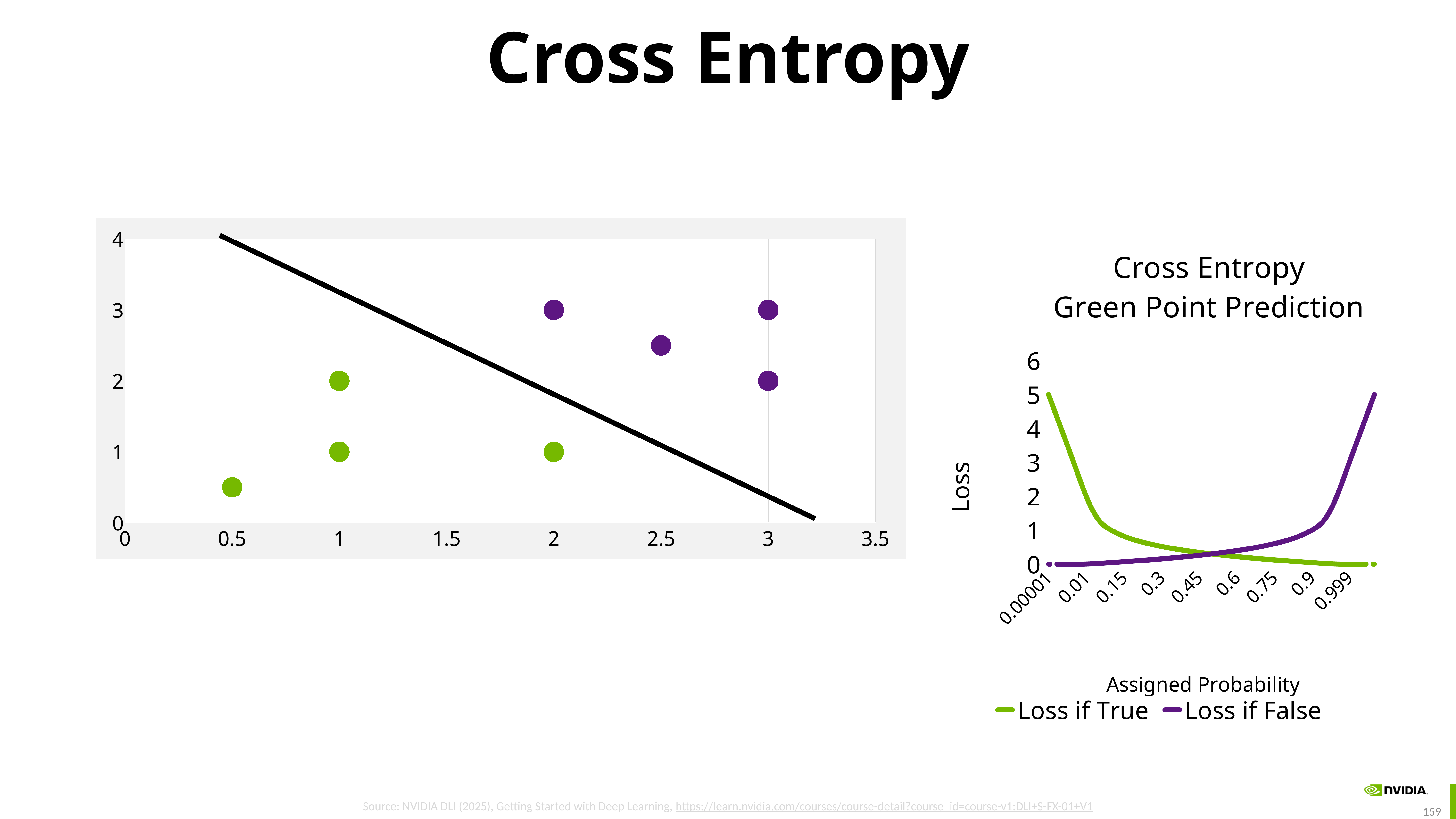
What kind of chart is the chart on the left of the slide? scatter chart What is the y-axis title of the 'Cross Entropy Green Point Prediction' chart? Loss In the 'Cross Entropy Green Point Prediction' chart, how many assigned probability labels are shown on the x axis? 9 In the 'Cross Entropy Green Point Prediction' chart, is the 'Loss if True' value at 0.00001 greater or less than 4? greater In the 'Cross Entropy Green Point Prediction' chart, does the 'Loss if False' line rise or fall as assigned probability increases? rise What kind of chart is the chart titled 'Cross Entropy Green Point Prediction'? line chart In the chart on the left, how many points are plotted in total? 8 In the 'Cross Entropy Green Point Prediction' chart, at an assigned probability of 0.9, which series has the larger loss, 'Loss if True' or 'Loss if False'? Loss if False In the chart on the left, how many green points are plotted? 4 In the 'Cross Entropy Green Point Prediction' chart, does the 'Loss if True' line rise or fall as assigned probability increases? fall How many series does the legend of the 'Cross Entropy Green Point Prediction' chart list? 2